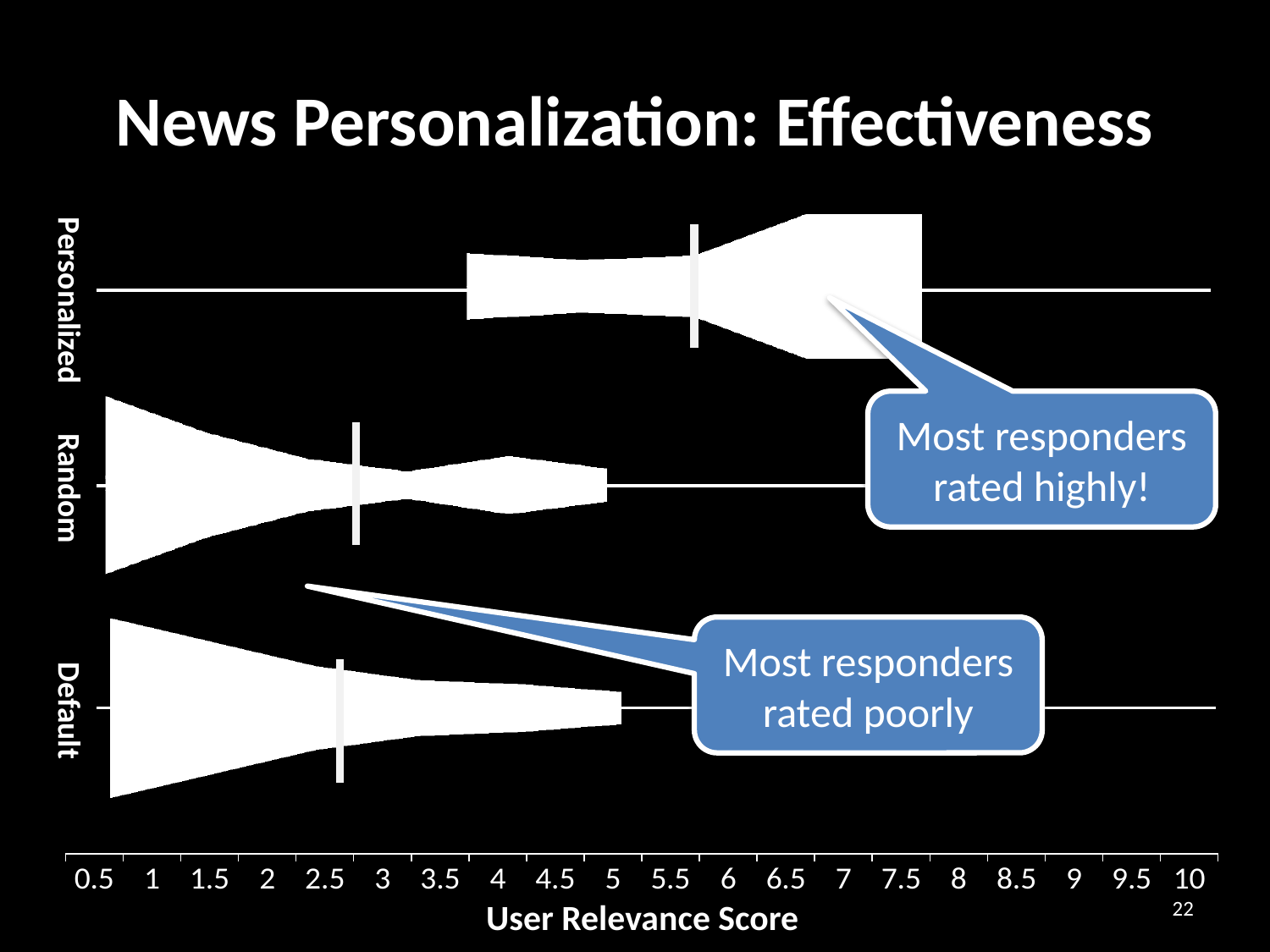
Is the median User Relevance Score for Default greater or less than 3? less What is the title of the chart on the slide? News Personalization: Effectiveness What is the label of the horizontal axis? User Relevance Score Which has a higher median User Relevance Score, Default or Personalized? Personalized How many categories are plotted on the vertical axis? 3 Which category has the highest median User Relevance Score? Personalized Is the median User Relevance Score for Personalized greater or less than 5? greater What is the highest tick value shown on the horizontal axis? 10 What is the lowest tick value shown on the horizontal axis? 0.5 Which has a higher median User Relevance Score, Personalized or Random? Personalized Is the median User Relevance Score for Random greater or less than 3? less